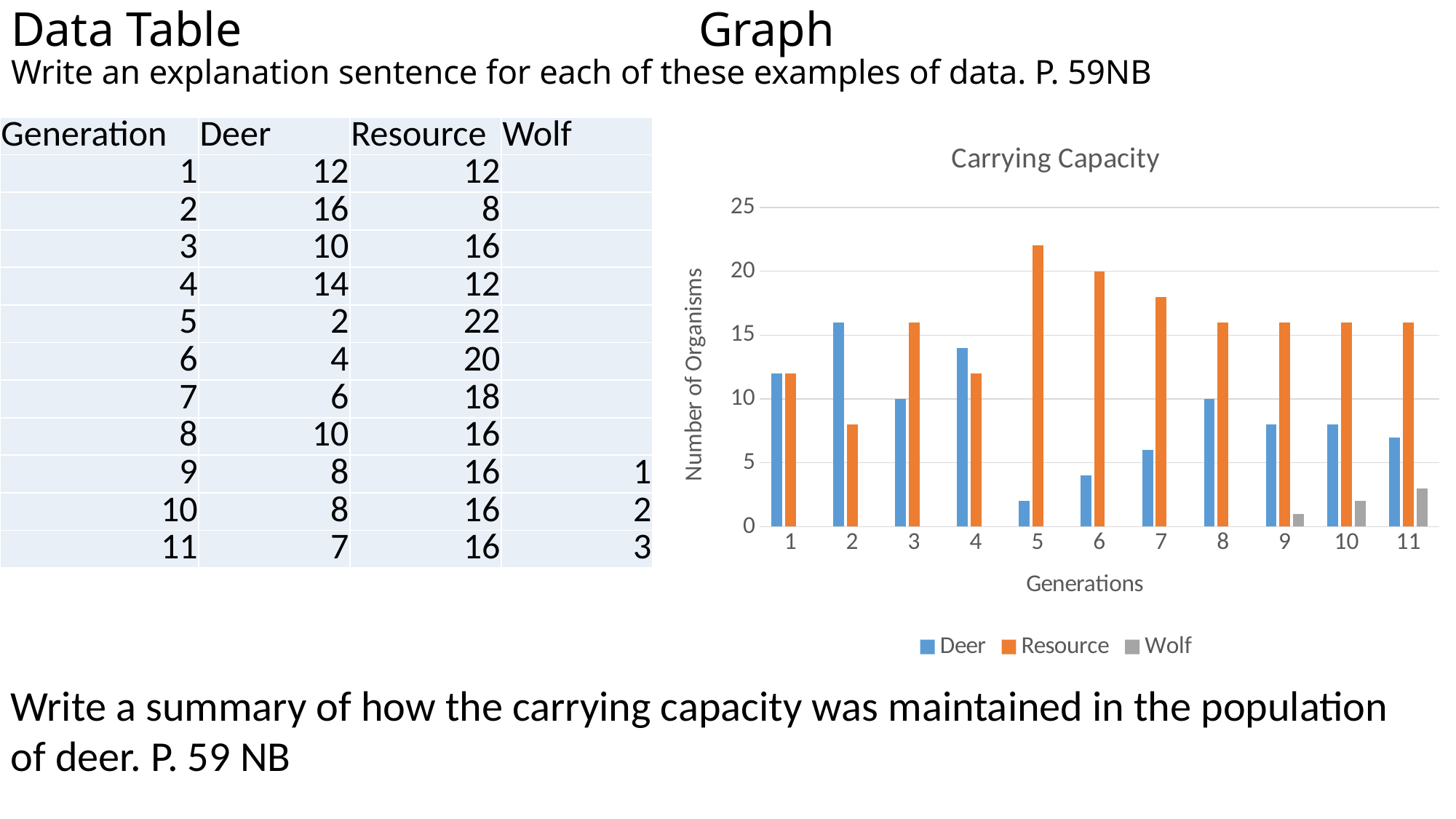
How many series does the legend of the Carrying Capacity chart list? 3 At generation 2 in the Carrying Capacity chart, which is larger, Deer or Resource? Deer How many generations are shown on the x axis of the Carrying Capacity chart? 11 Is the Resource value at generation 7 in the Carrying Capacity chart greater or less than 15? greater What is the difference between the Resource and Deer values at generation 6 in the Carrying Capacity chart? 16 What type of chart is the Carrying Capacity chart? bar chart What is the Wolf value at generation 11 in the Carrying Capacity chart? 3 At which generation is the Deer value lowest in the Carrying Capacity chart? 5 What is the label on the y axis of the Carrying Capacity chart? Number of Organisms At which generation is the Resource value highest in the Carrying Capacity chart? 5 What is the Deer value at generation 2 in the Carrying Capacity chart? 16 What is the Resource value at generation 5 in the Carrying Capacity chart? 22